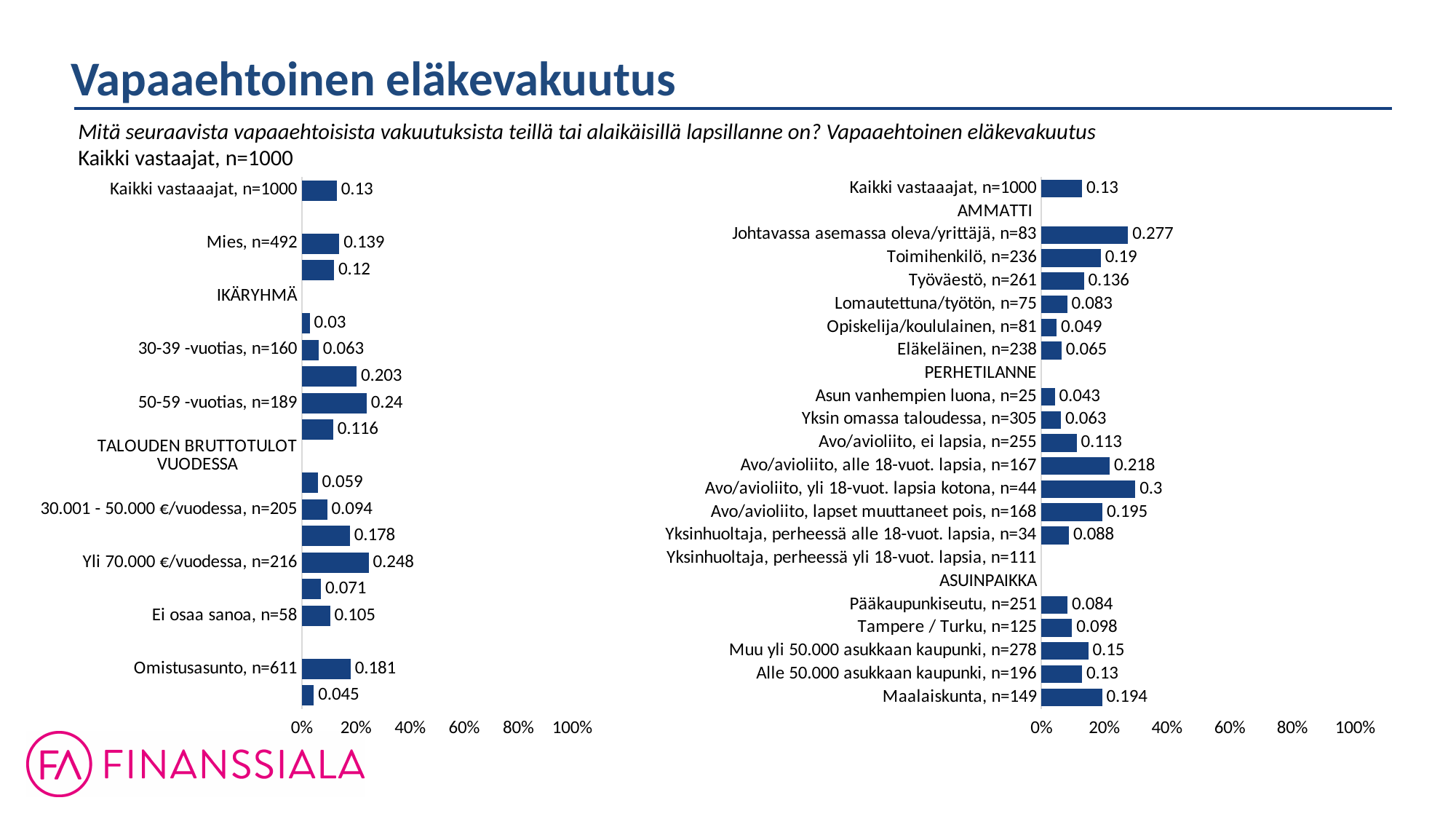
In the right-hand chart, which category has the highest value? Avo/avioliito, yli 18-vuot. lapsia kotona, n=44 What is the title of the slide? Vapaaehtoinen eläkevakuutus In the right-hand chart, is the value for Avo/avioliito, yli 18-vuot. lapsia kotona, n=44 greater or less than 20%? greater In the right-hand chart, which category in the AMMATTI group has the lowest value? Opiskelija/koululainen, n=81 What kind of chart is the right-hand chart on the slide? bar chart In the right-hand chart, what is the value for Tampere / Turku, n=125? 0.098 In the left-hand chart, what is the value for Yli 70.000 €/vuodessa, n=216? 0.248 In the right-hand chart, what is the value for Johtavassa asemassa oleva/yrittäjä, n=83? 0.277 In the right-hand chart, what is the difference between the values for Toimihenkilö, n=236 and Työväestö, n=261? 0.054 In the right-hand chart, what is the value for Maalaiskunta, n=149? 0.194 In the left-hand chart, what is the difference between the values for 50-59 -vuotias, n=189 and 30-39 -vuotias, n=160? 0.177 In the left-hand chart, which is larger: the value for Mies, n=492 or the value for Omistusasunto, n=611? Omistusasunto, n=611